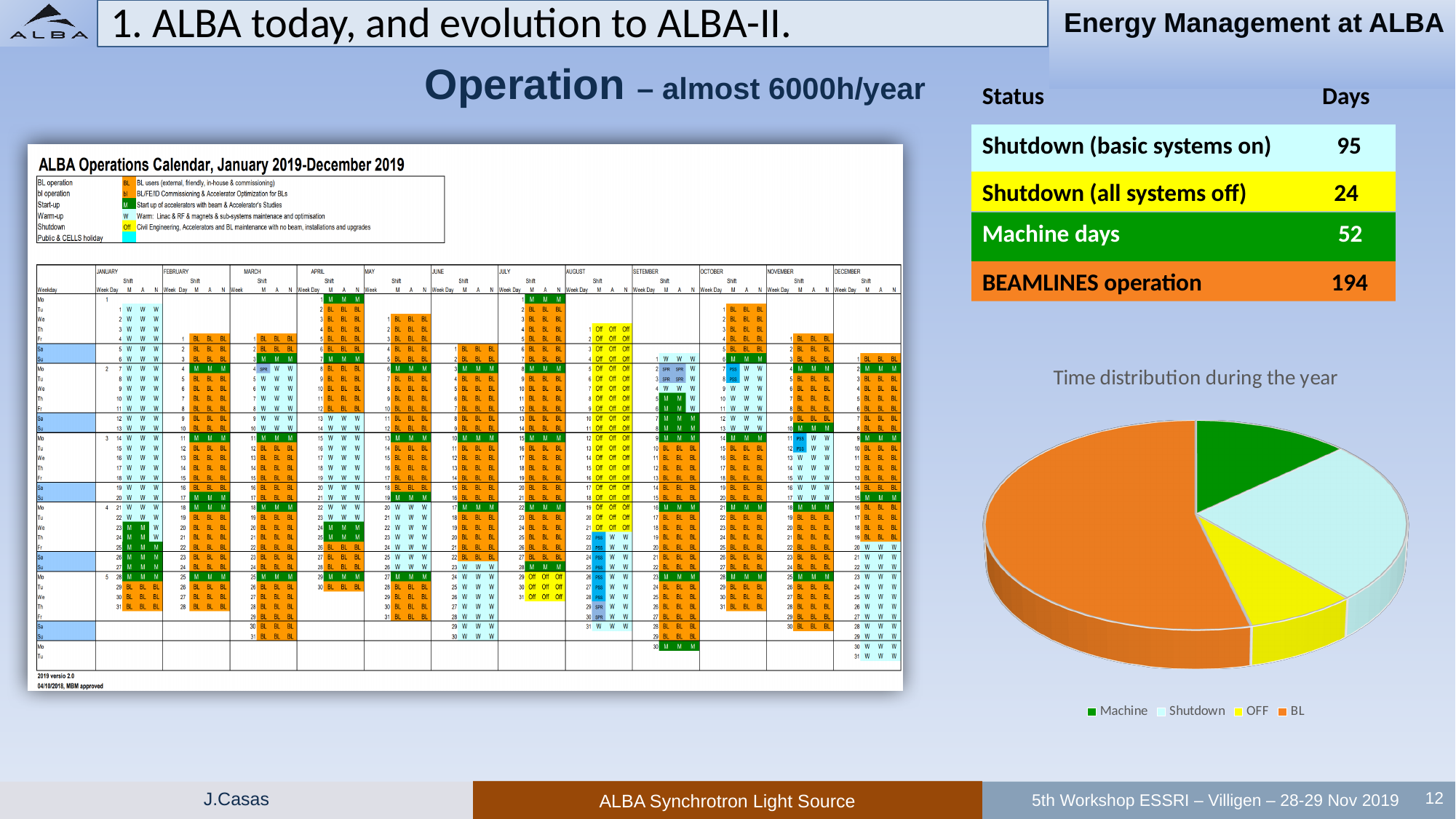
Which category has the largest slice in the "Time distribution during the year" pie chart? BL In the "Time distribution during the year" pie chart, which slice is larger, BL or Shutdown? BL How many slices does the "Time distribution during the year" pie chart have? 4 What kind of chart is the "Time distribution during the year" chart? pie chart What colour is the BL slice in the "Time distribution during the year" pie chart? orange In the "Time distribution during the year" pie chart, which slice is larger, Shutdown or Machine? Shutdown What is the title of the pie chart on the slide? Time distribution during the year Which category has the smallest slice in the "Time distribution during the year" pie chart? OFF In the "Time distribution during the year" pie chart, which slice is larger, Machine or OFF? Machine How many entries does the legend of the "Time distribution during the year" pie chart list? 4